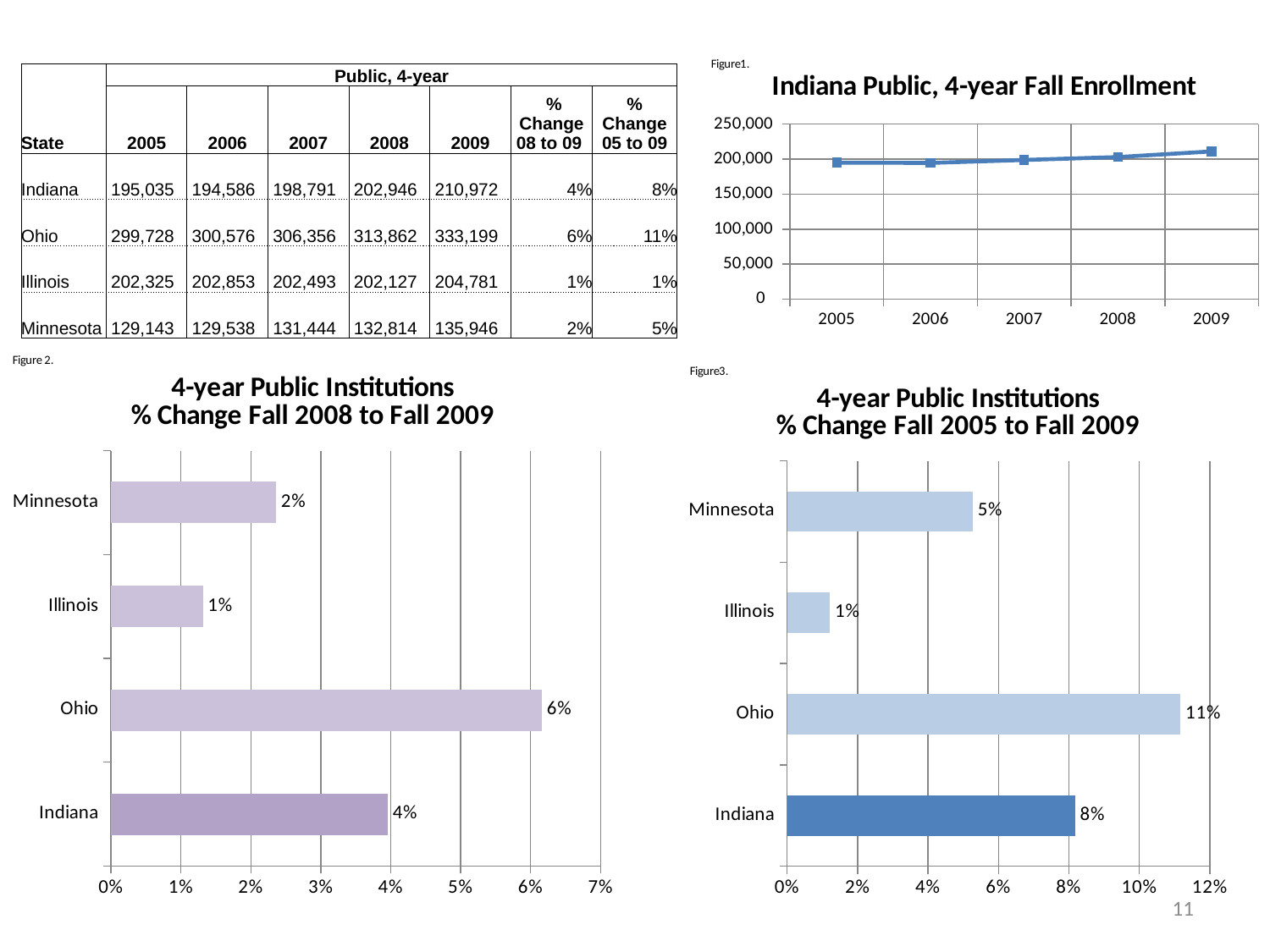
In the chart titled 'Indiana Public, 4-year Fall Enrollment', do the values generally rise or fall from 2006 to 2009? Rise In the chart titled 'Indiana Public, 4-year Fall Enrollment', is the value for 2009 greater or less than 200,000? greater What kind of chart is the one titled 'Indiana Public, 4-year Fall Enrollment'? Line chart In the chart titled '4-year Public Institutions % Change Fall 2008 to Fall 2009', what is the value for Ohio? 6% In the chart titled '4-year Public Institutions % Change Fall 2005 to Fall 2009', which state has the lowest value? Illinois In the chart titled '4-year Public Institutions % Change Fall 2008 to Fall 2009', which state has the highest value? Ohio What kind of chart is the one titled '4-year Public Institutions % Change Fall 2008 to Fall 2009'? Bar chart In the chart titled 'Indiana Public, 4-year Fall Enrollment', is the value for 2006 greater or less than 200,000? less In the chart titled '4-year Public Institutions % Change Fall 2005 to Fall 2009', what is the value for Indiana? 8% In the chart titled '4-year Public Institutions % Change Fall 2005 to Fall 2009', what is the difference between the values for Ohio and Minnesota? 6% How many states are shown in the chart titled '4-year Public Institutions % Change Fall 2005 to Fall 2009'? 4 In the chart titled '4-year Public Institutions % Change Fall 2008 to Fall 2009', which is larger, the value for Indiana or the value for Minnesota? Indiana